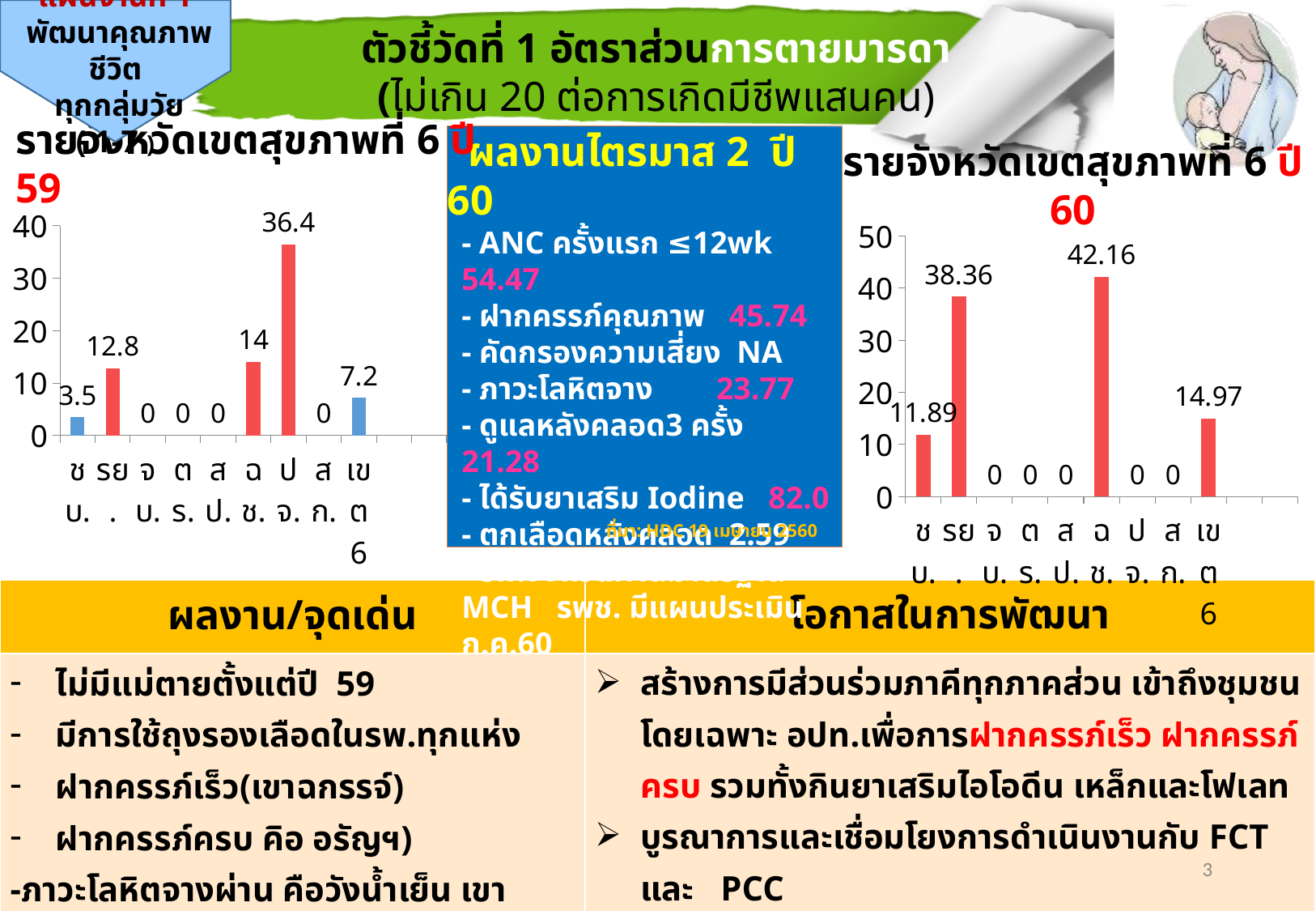
What type of chart is the left chart (ปี 59)? Bar chart In the right chart (ปี 60), what is the value for ชบ.? 11.89 In the right chart (ปี 60), which category has the highest value? ฉช. In the right chart (ปี 60), how many categories have a value of 0? 5 In the left chart (ปี 59), which category has the highest value? ปจ. In the left chart (ปี 59), what is the value for ปจ.? 36.4 In the right chart (ปี 60), which is larger, the value for รย. or the value for เขต? รย. In the left chart (ปี 59), what is the difference between the values for ปจ. and ฉช.? 22.4 In the right chart (ปี 60), what is the value for ฉช.? 42.16 In the right chart (ปี 60), what is the difference between the values for ฉช. and รย.? 3.80 In the left chart (ปี 59), how many categories are shown on the x axis? 9 In the left chart (ปี 59), what is the value for รย.? 12.8